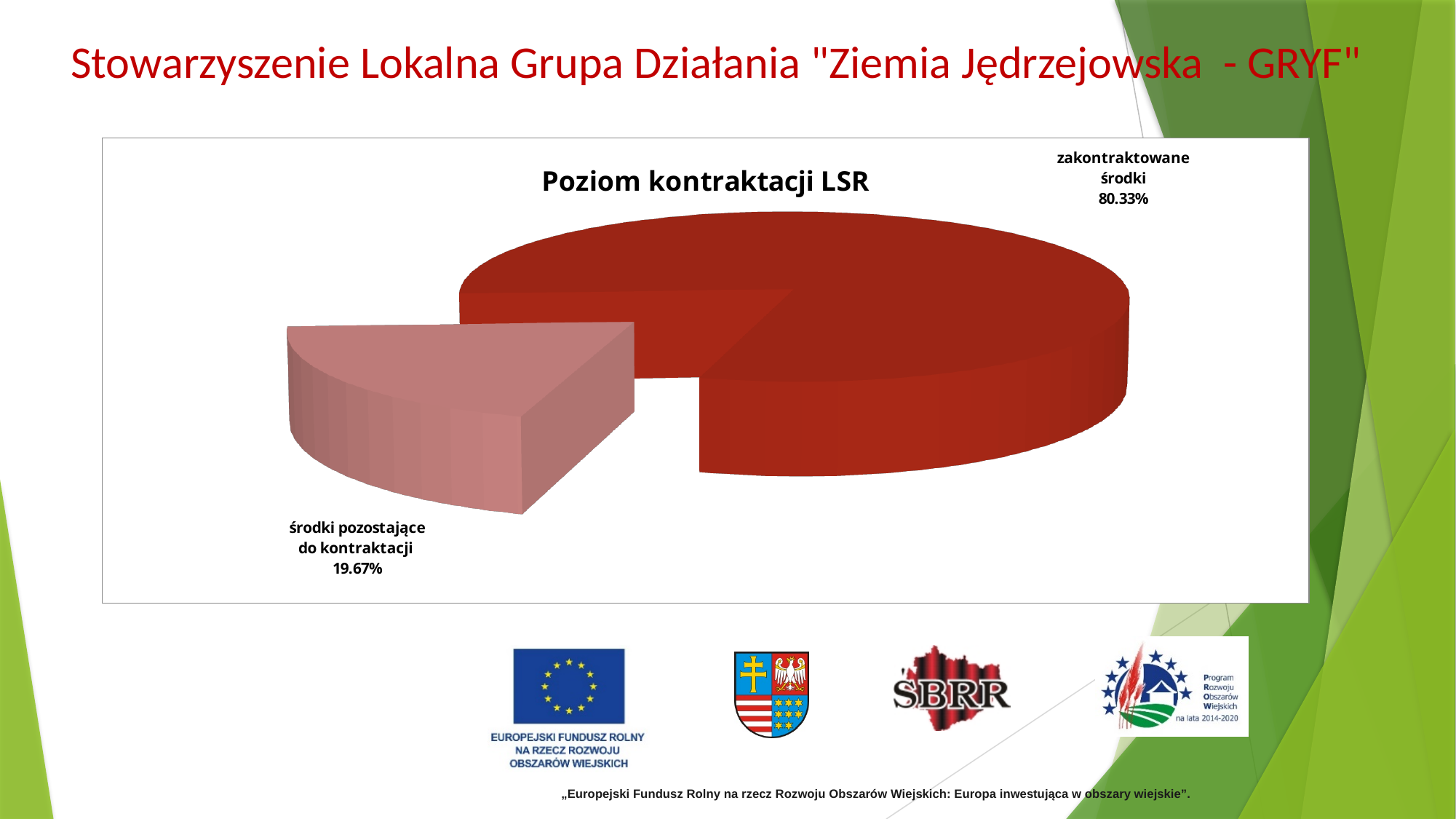
What share of the pie is labelled "środki pozostające do kontraktacji"? 19.67% What is the title of the chart? Poziom kontraktacji LSR What kind of chart is shown on the slide? pie chart What is the total of the two slice percentages shown on the pie chart? 100% What is the difference in percentage points between the "zakontraktowane środki" slice and the "środki pozostające do kontraktacji" slice? 60.66 What share of the pie is labelled "zakontraktowane środki"? 80.33% Which is larger: the "zakontraktowane środki" slice or the "środki pozostające do kontraktacji" slice? zakontraktowane środki How many slices does the pie chart have? 2 What colour is the "środki pozostające do kontraktacji" slice? light pink Which slice of the pie is the largest? zakontraktowane środki Which slice of the pie is the smallest? środki pozostające do kontraktacji